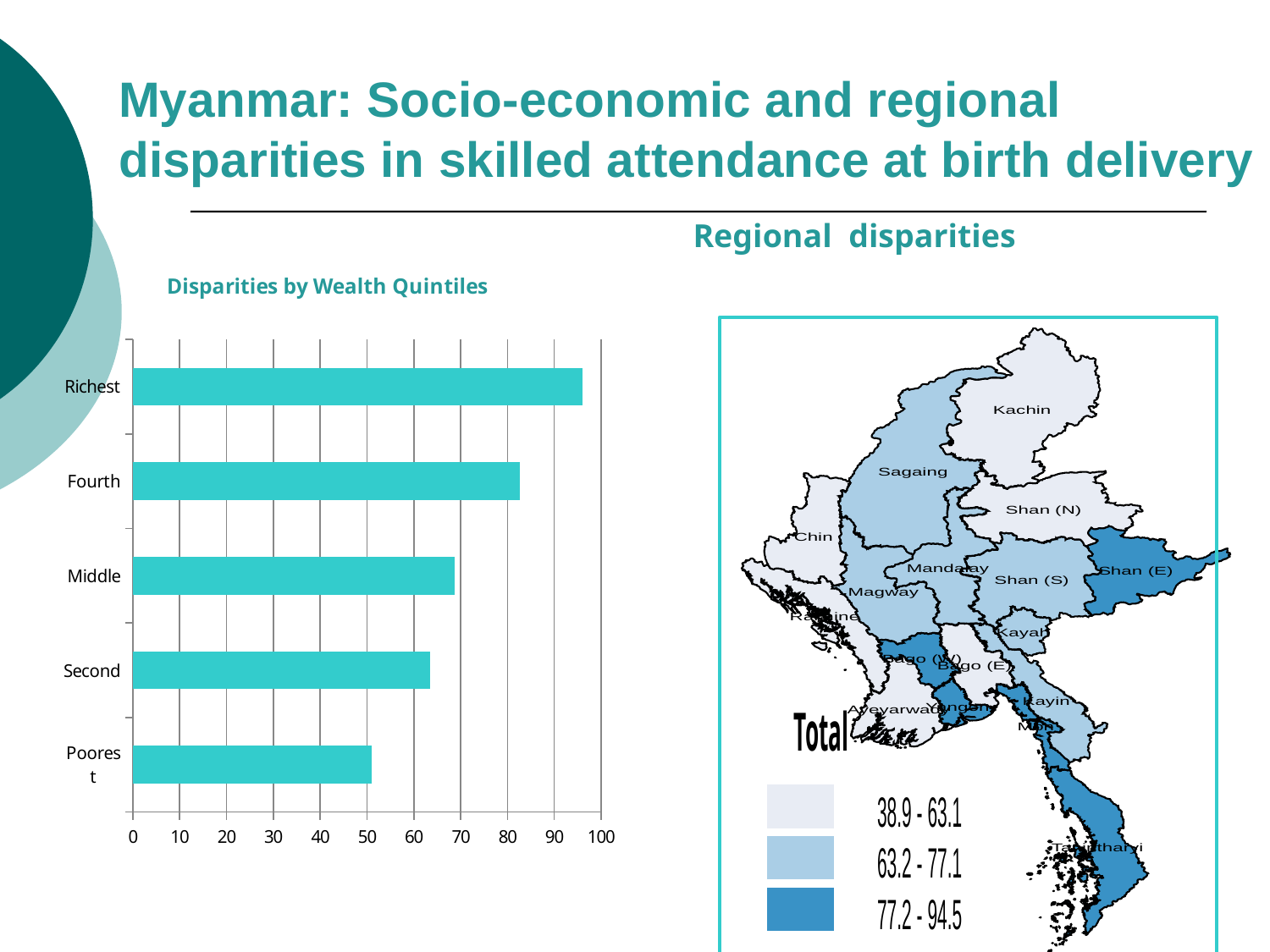
In the 'Disparities by Wealth Quintiles' chart, which quintile has the lowest value? Poorest What is the highest value shown on the horizontal axis of the 'Disparities by Wealth Quintiles' chart? 100 In the 'Disparities by Wealth Quintiles' chart, is the value for Second greater or less than 70? less In the 'Disparities by Wealth Quintiles' chart, is the value for Richest greater or less than 90? greater In the 'Disparities by Wealth Quintiles' chart, which quintile has the highest value? Richest What kind of chart is 'Disparities by Wealth Quintiles'? bar chart In the 'Disparities by Wealth Quintiles' chart, do the values rise or fall going from Richest down to Poorest? fall In the 'Disparities by Wealth Quintiles' chart, is the value for Middle greater or less than 60? greater In the 'Disparities by Wealth Quintiles' chart, which is larger, the value for Fourth or the value for Middle? Fourth In the 'Disparities by Wealth Quintiles' chart, how many wealth quintile categories are shown? 5